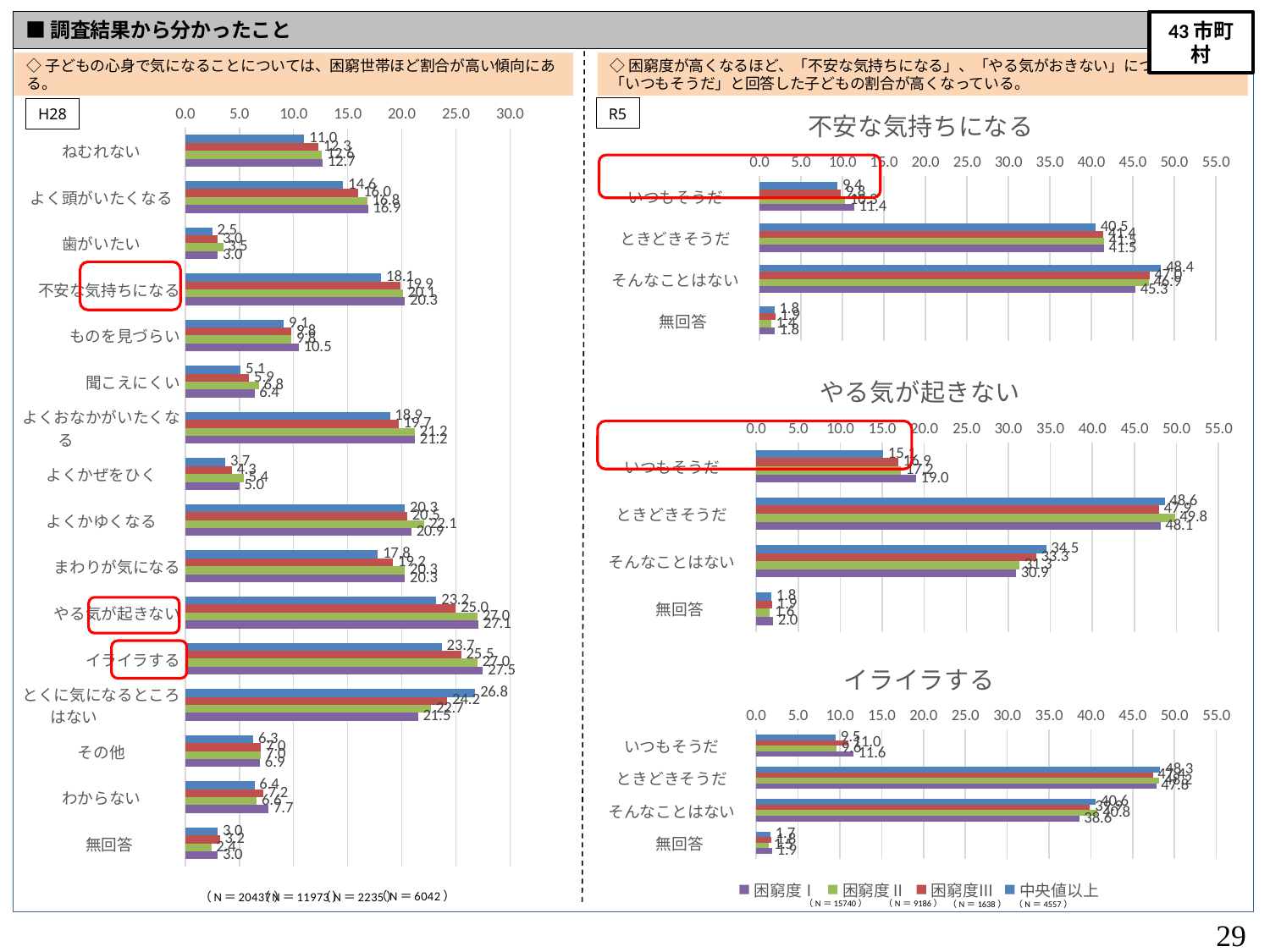
In the chart titled 「不安な気持ちになる」, which is larger in the category いつもそうだ: 困窮度Ⅰ or 中央値以上? 困窮度Ⅰ How many series does the legend at the bottom right of the slide list? 4 In the chart titled 「不安な気持ちになる」, what is the difference between 中央値以上 and 困窮度Ⅰ in the category そんなことはない? 3.1 In the chart titled 「イライラする」, what is the value for 困窮度Ⅰ in the category そんなことはない? 38.6 In the H28 chart on the left, what is the value for 中央値以上 in the category とくに気になるところはない? 26.8 In the chart titled 「不安な気持ちになる」, what is the value for 困窮度Ⅰ in the category いつもそうだ? 11.4 In the chart titled 「不安な気持ちになる」, what is the value for 中央値以上 in the category そんなことはない? 48.4 In the chart titled 「やる気が起きない」, what is the value for 困窮度Ⅰ in the category いつもそうだ? 19.0 In the chart titled 「イライラする」, is the value for 困窮度Ⅰ in the category ときどきそうだ greater or less than 45.0? greater What kind of chart is the chart titled 「やる気が起きない」? bar chart In the chart titled 「やる気が起きない」, which response category has the highest values? ときどきそうだ In the H28 chart on the left, what is the value for 困窮度Ⅰ in the category イライラする? 27.5